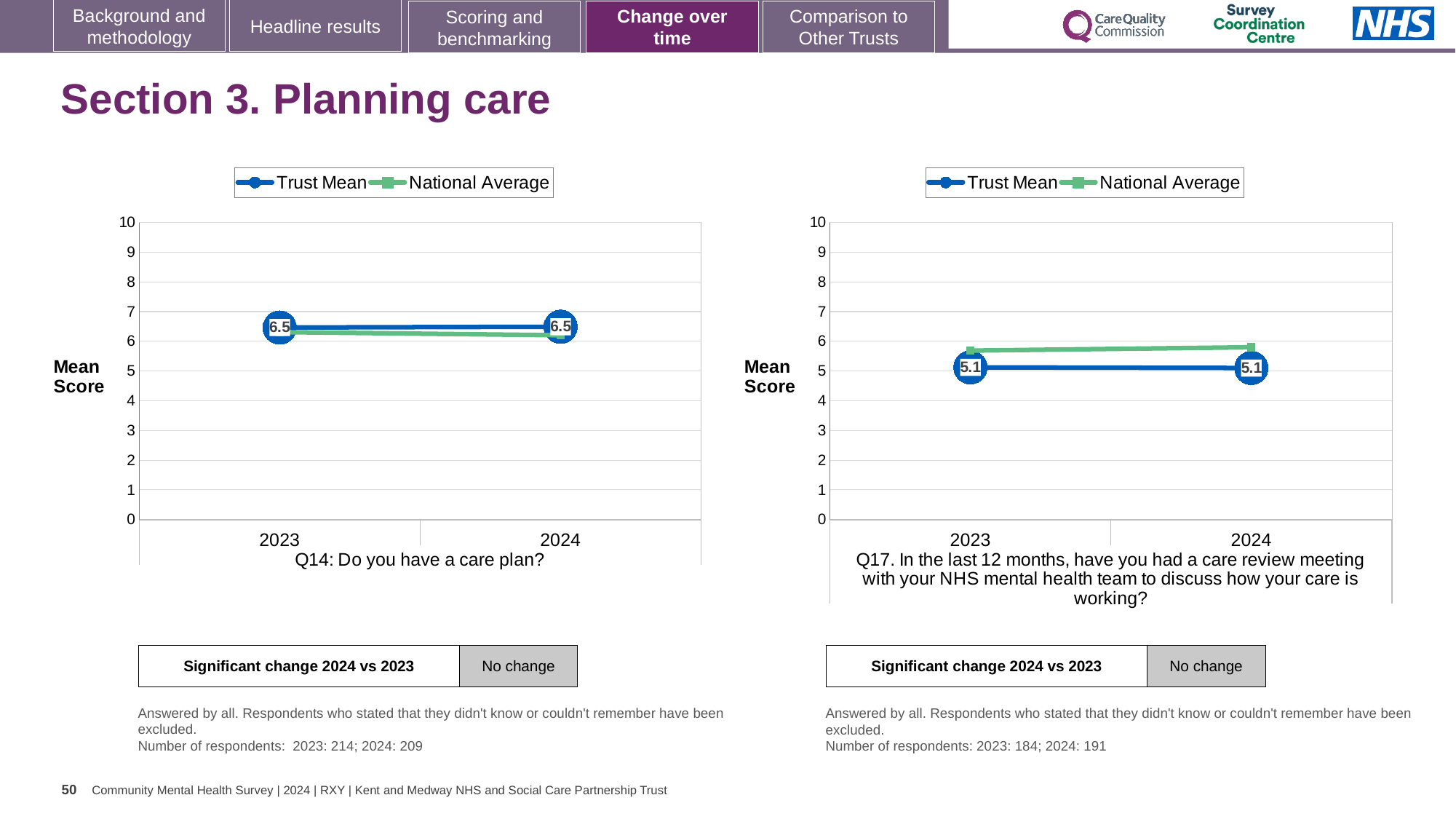
What kind of chart is the right chart (Q17)? line chart How many years are plotted on the x axis of the left chart (Q14)? 2 How many series does the legend of the left chart (Q14) list? 2 In the left chart (Q14: Do you have a care plan?), what is the Trust Mean score for 2024? 6.5 In the left chart (Q14: Do you have a care plan?), what is the Trust Mean score for 2023? 6.5 In the right chart (Q17), is the National Average for 2023 greater or less than 6? less In the right chart (Q17, care review meeting), what is the Trust Mean score for 2024? 5.1 In the right chart (Q17), which is larger in 2024: the Trust Mean or the National Average? National Average In the right chart (Q17), does the Trust Mean rise, fall or stay the same from 2023 to 2024? stays the same In the left chart (Q14), what is the difference between the Trust Mean in 2024 and the Trust Mean in 2023? 0 In the right chart (Q17, care review meeting), what is the Trust Mean score for 2023? 5.1 In the right chart (Q17), is the National Average for 2024 greater or less than 5? greater